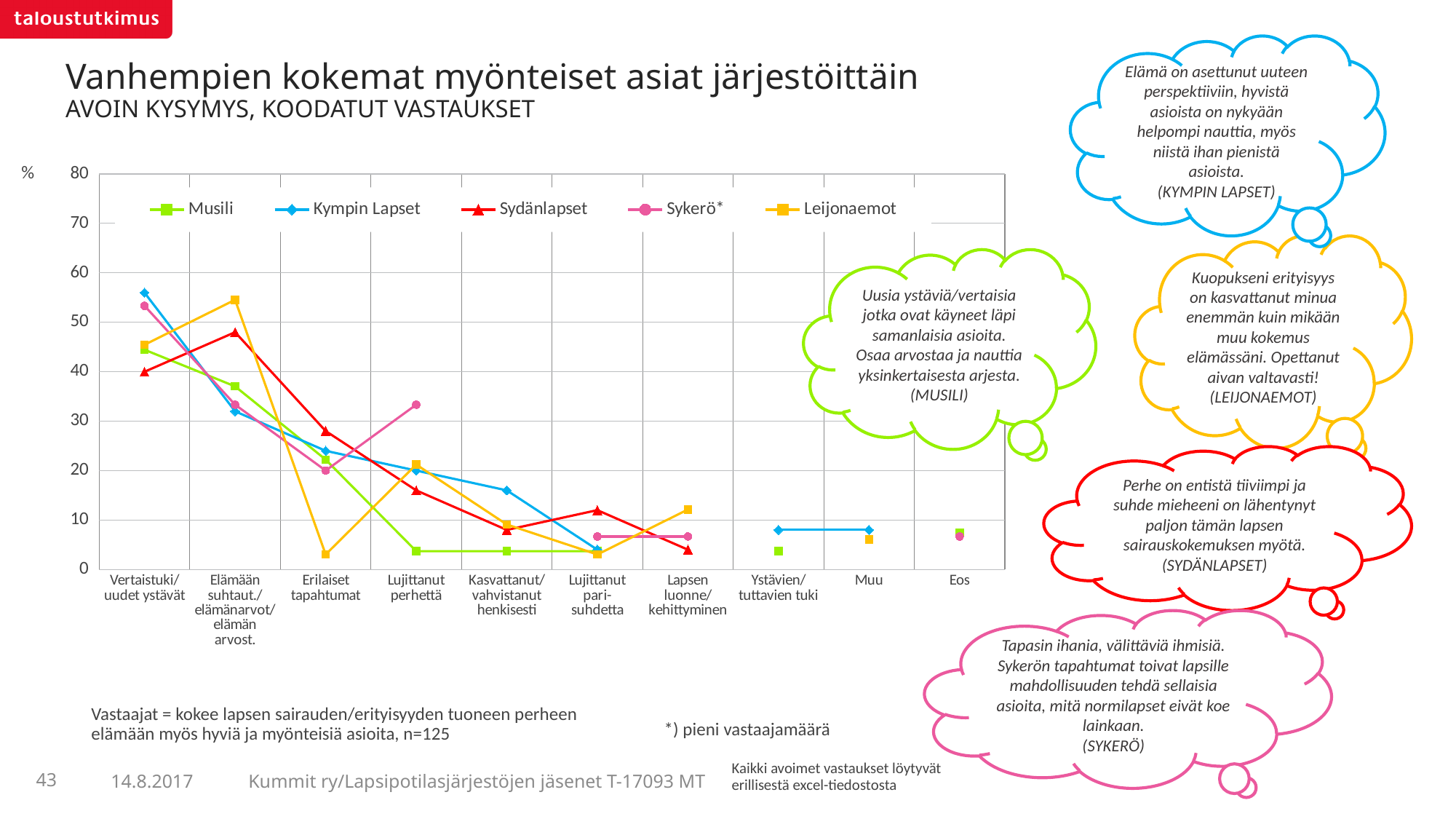
Which series in the legend is marked with an asterisk? Sykerö How many series does the legend list? 5 At Lujittanut perhettä, which is larger: Sykerö or Musili? Sykerö At Vertaistuki/uudet ystävät, which is larger: Musili or Sydänlapset? Musili Is the value for Kympin Lapset at Vertaistuki/uudet ystävät greater or less than 50? greater What kind of chart is shown on the slide? line chart How many categories are shown along the x axis? 10 Is the value for Leijonaemot at Erilaiset tapahtumat greater or less than 10? less Which series has the lowest value at Erilaiset tapahtumat? Leijonaemot Which series has the highest value at Elämään suhtaut./elämänarvot/elämän arvost.? Leijonaemot Is the value for Sydänlapset at Lujittanut parisuhdetta greater or less than 10? greater Does the Musili line rise or fall from Vertaistuki/uudet ystävät to Lujittanut perhettä? fall